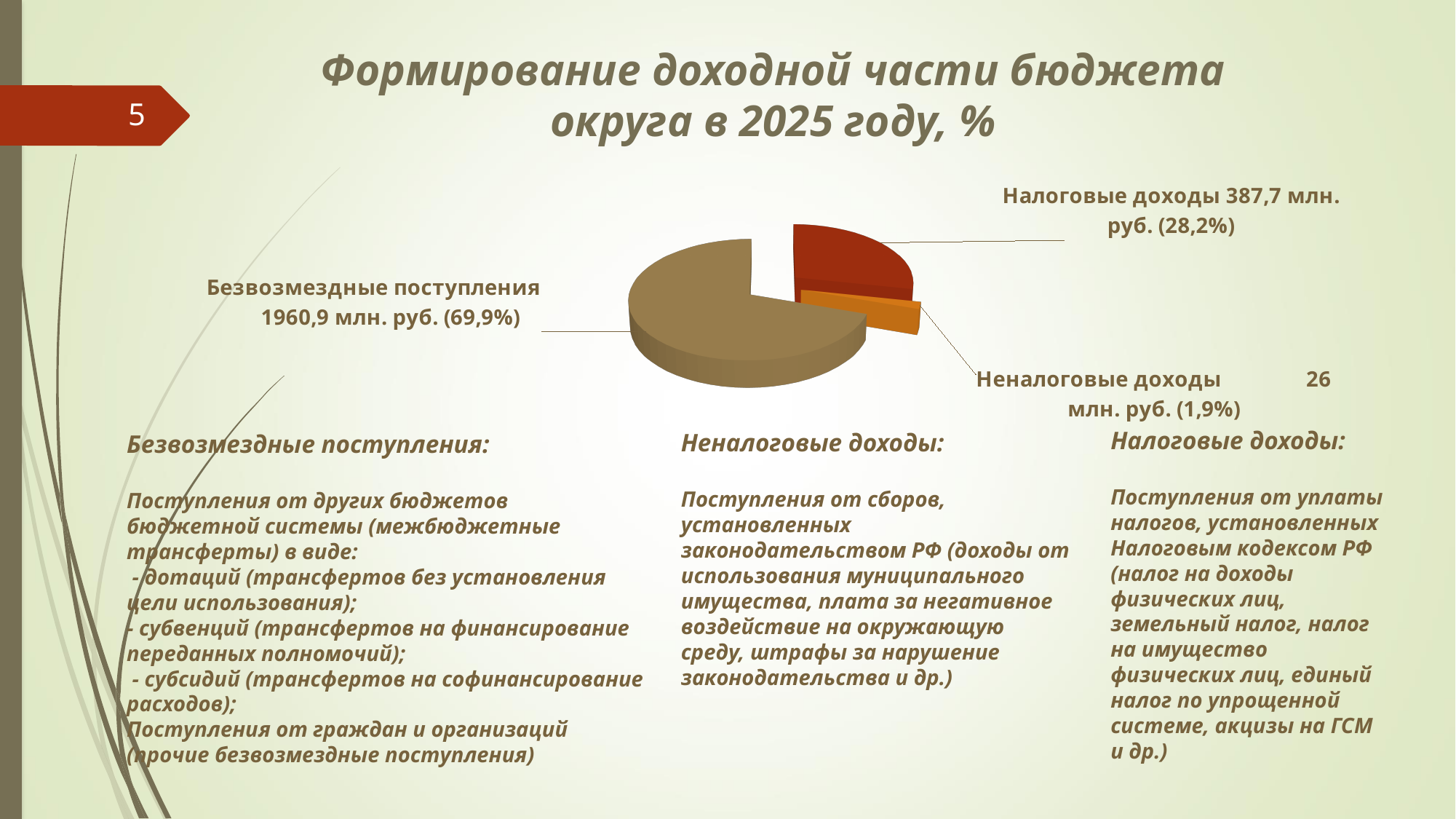
What share of the pie do Безвозмездные поступления make up? 69,9% What is the title of the chart on the slide? Формирование доходной части бюджета округа в 2025 году, % What is the difference in млн. руб. between Безвозмездные поступления and Налоговые доходы? 1573,2 млн. руб. What kind of chart is shown on the slide? Pie chart Which category has the largest slice of the pie? Безвозмездные поступления Which category has the smallest slice of the pie? Неналоговые доходы What is the value shown for Налоговые доходы? 387,7 млн. руб. (28,2%) Which is larger, Налоговые доходы or Неналоговые доходы? Налоговые доходы How many slices does the pie chart have? 3 What is the value shown for Неналоговые доходы? 26 млн. руб. (1,9%) What is the value shown for Безвозмездные поступления? 1960,9 млн. руб. (69,9%) What share of the pie do Налоговые доходы make up? 28,2%